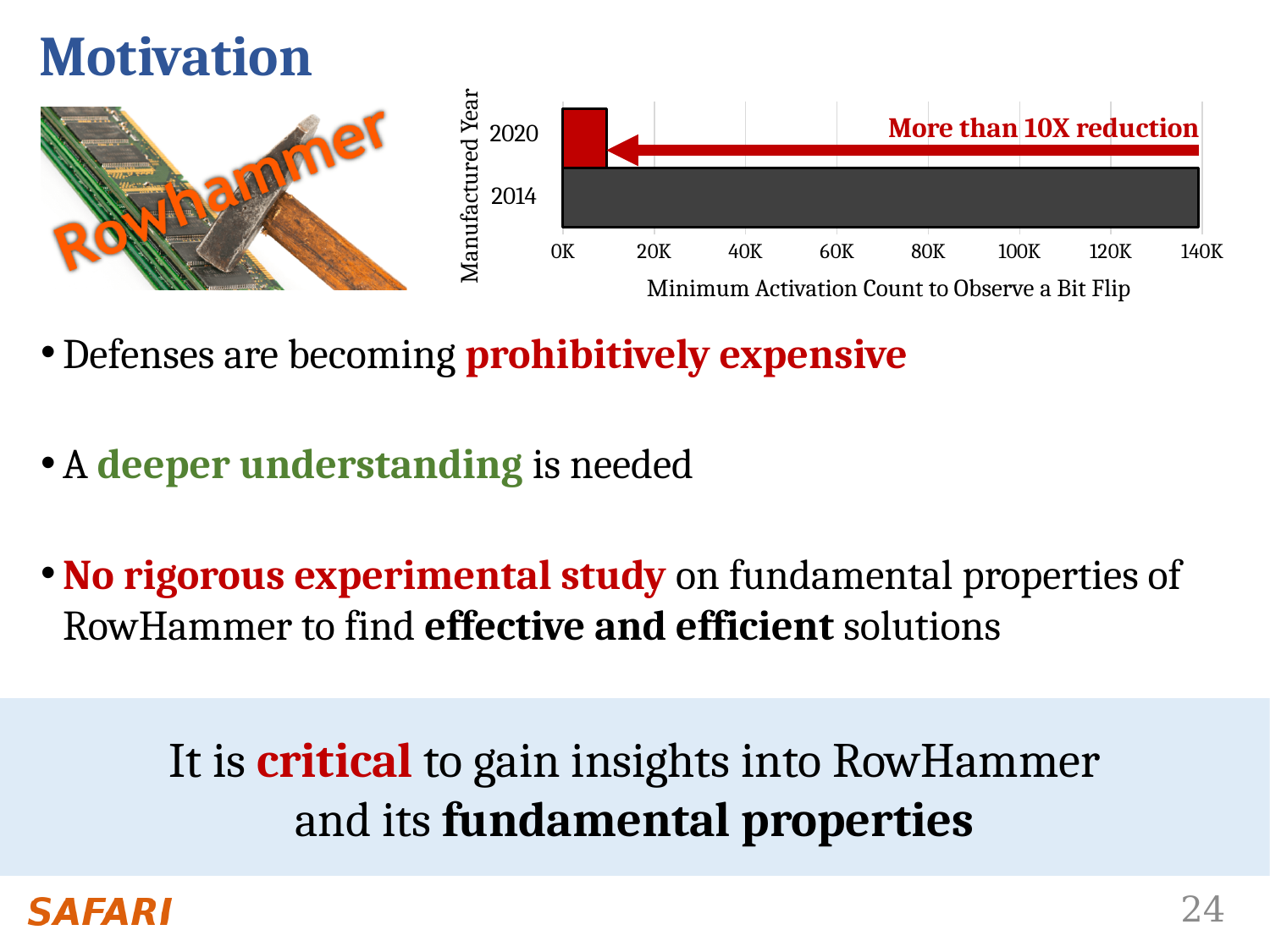
Which manufactured year has the lower minimum activation count to observe a bit flip? 2020 Which manufactured year has the higher minimum activation count to observe a bit flip? 2014 What kind of chart is shown on the slide? bar chart Is the minimum activation count for 2020 greater or less than 20K? less Is the minimum activation count for 2020 larger or smaller than for 2014? smaller Is the minimum activation count for 2014 greater or less than 100K? greater What is the label of the horizontal axis of the chart? Minimum Activation Count to Observe a Bit Flip Is the minimum activation count for 2014 greater or less than 120K? greater What reduction does the annotation on the chart state between 2014 and 2020? More than 10X reduction How many manufactured years are plotted in the chart? 2